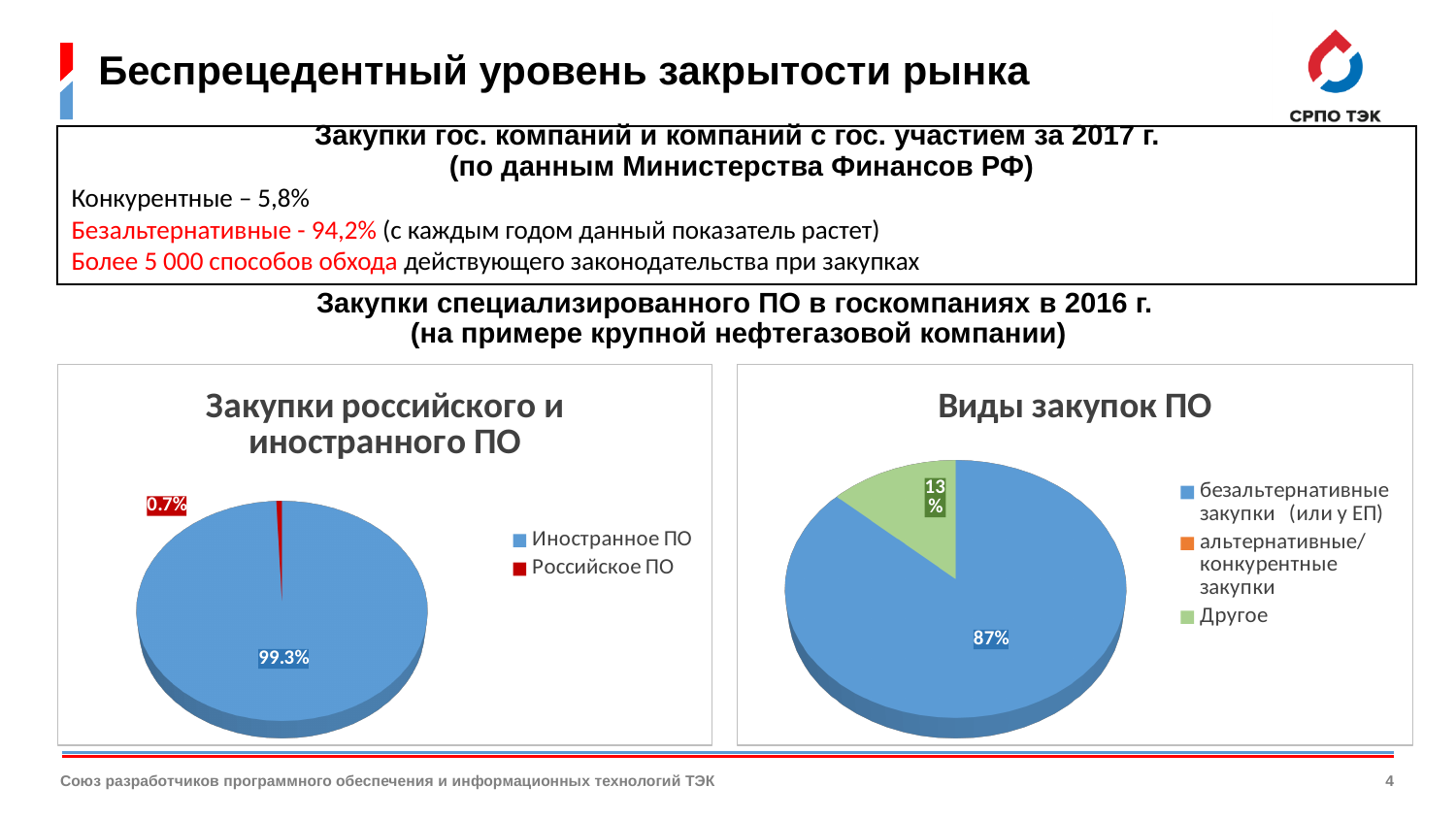
In the chart titled "Закупки российского и иностранного ПО", what share is labelled for Иностранное ПО? 99.3% In the chart titled "Закупки российского и иностранного ПО", what share is labelled for Российское ПО? 0.7% How many series does the legend of the chart titled "Закупки российского и иностранного ПО" list? 2 In the chart titled "Виды закупок ПО", which category has the largest slice? безальтернативные закупки (или у ЕП) How many entries does the legend of the chart titled "Виды закупок ПО" list? 3 In the chart titled "Виды закупок ПО", what share is labelled for безальтернативные закупки (или у ЕП)? 87% In the chart titled "Виды закупок ПО", what share is labelled for Другое? 13% What kind of chart is the one titled "Закупки российского и иностранного ПО"? Pie chart In the chart titled "Виды закупок ПО", what colour is the slice for Другое? Green In the chart titled "Закупки российского и иностранного ПО", what is the difference between the Иностранное ПО and Российское ПО shares? 98.6% In the chart titled "Закупки российского и иностранного ПО", which category has the largest slice? Иностранное ПО In the chart titled "Закупки российского и иностранного ПО", which category has the smallest slice? Российское ПО